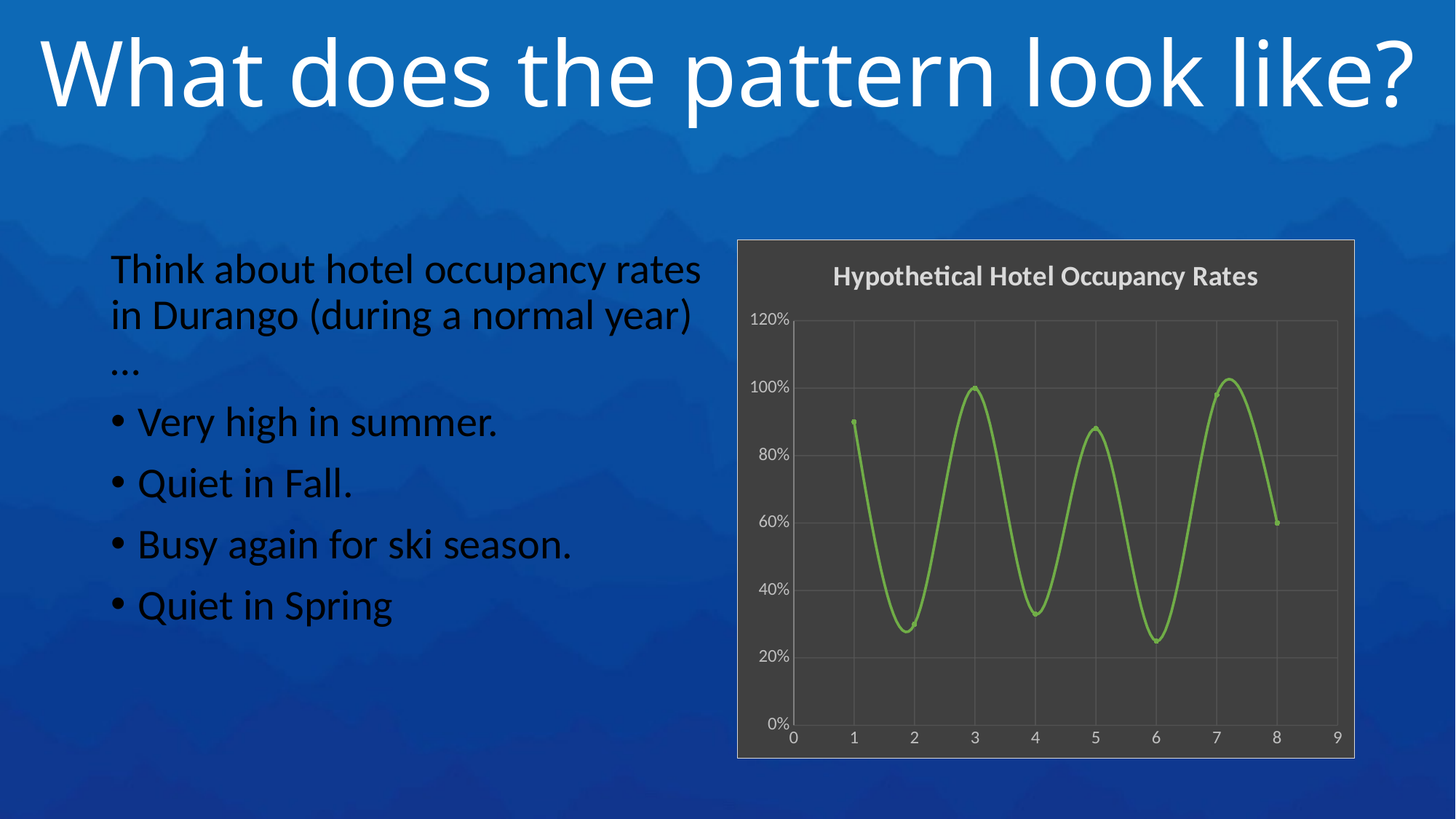
What colour is the plotted line? green What is the occupancy rate at x = 8? 60% Which is larger, the value at x = 1 or the value at x = 2? x = 1 What is the occupancy rate at x = 3? 100% Is the value at x = 5 greater or less than 80%? greater Is the value at x = 2 greater or less than 40%? less What is the title of the chart? Hypothetical Hotel Occupancy Rates What type of chart is shown on the slide? line chart Do the values rise or fall from x = 2 to x = 3? rise Is the value at x = 6 greater or less than 40%? less How many data points are plotted on the line? 8